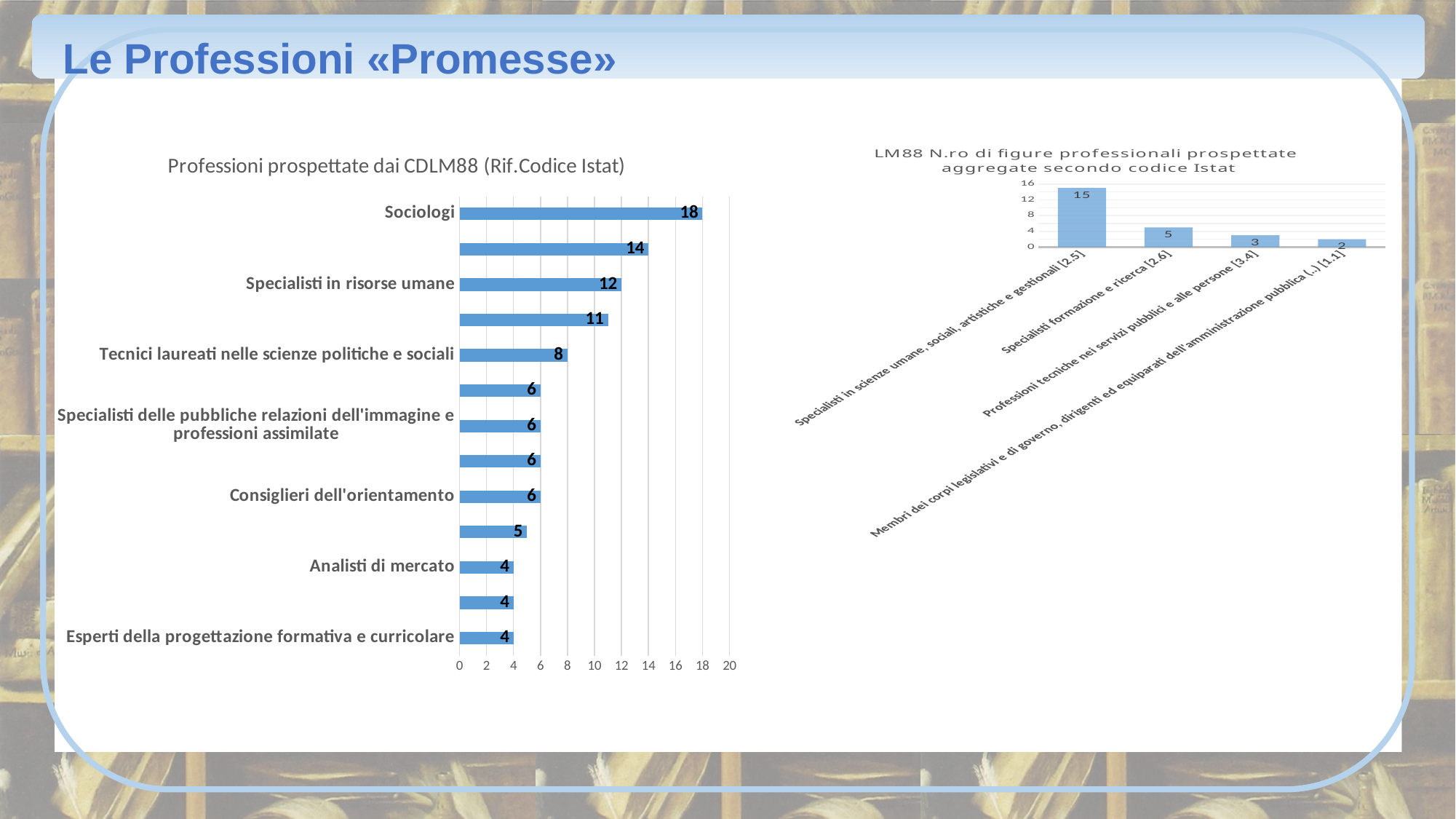
In the chart 'LM88 N.ro di figure professionali prospettate aggregate secondo codice Istat', what is the value for Specialisti in scienze umane, sociali, artistiche e gestionali [2.5]? 15 In the chart 'Professioni prospettate dai CDLM88 (Rif.Codice Istat)', which is larger: the value for Consiglieri dell'orientamento or the value for Analisti di mercato? Consiglieri dell'orientamento In the chart 'Professioni prospettate dai CDLM88 (Rif.Codice Istat)', what is the value for Analisti di mercato? 4 In the chart 'LM88 N.ro di figure professionali prospettate aggregate secondo codice Istat', what is the difference between the values for Specialisti formazione e ricerca [2.6] and Professioni tecniche nei servizi pubblici e alle persone [3.4]? 2 In the chart 'Professioni prospettate dai CDLM88 (Rif.Codice Istat)', what is the value for Sociologi? 18 What kind of chart is 'Professioni prospettate dai CDLM88 (Rif.Codice Istat)'? Bar chart In the chart 'Professioni prospettate dai CDLM88 (Rif.Codice Istat)', what is the difference between the values for Sociologi and Specialisti in risorse umane? 6 In the chart 'Professioni prospettate dai CDLM88 (Rif.Codice Istat)', how many bars are plotted? 13 In the chart 'Professioni prospettate dai CDLM88 (Rif.Codice Istat)', which category has the highest value? Sociologi In the chart 'Professioni prospettate dai CDLM88 (Rif.Codice Istat)', what is the value for Tecnici laureati nelle scienze politiche e sociali? 8 In the chart 'Professioni prospettate dai CDLM88 (Rif.Codice Istat)', what is the value for Specialisti in risorse umane? 12 In the chart 'LM88 N.ro di figure professionali prospettate aggregate secondo codice Istat', which category has the lowest value? Membri dei corpi legislativi e di governo, dirigenti ed equiparati dell'amministrazione pubblica (...) [1.1]